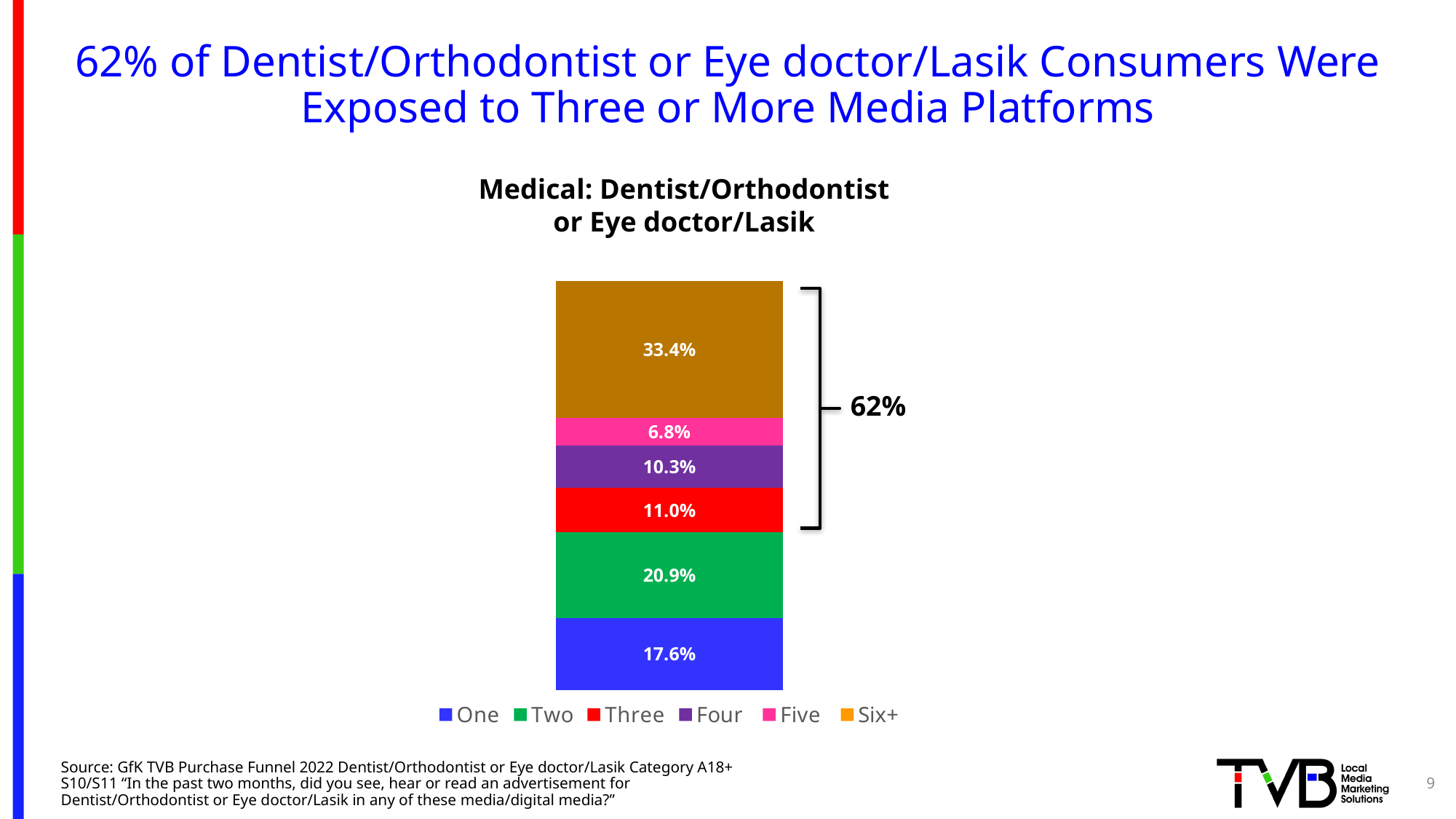
What is the title of the chart? Medical: Dentist/Orthodontist or Eye doctor/Lasik Which segment of the stacked bar has the largest value? Six+ What is the difference between the 'Two' segment and the 'One' segment? 3.3% What kind of chart is shown on the slide? Stacked bar chart What is the value for the 'Five' segment? 6.8% How many series does the legend list? 6 What is the value for the 'One' segment? 17.6% Which is larger, the 'Three' segment or the 'Four' segment? Three Which segment of the stacked bar has the smallest value? Five What percentage of consumers were exposed to six or more media platforms (Six+)? 33.4% What is the value for the 'Two' segment of the stacked bar? 20.9% What combined percentage does the bracket beside the bar indicate for three or more media platforms? 62%